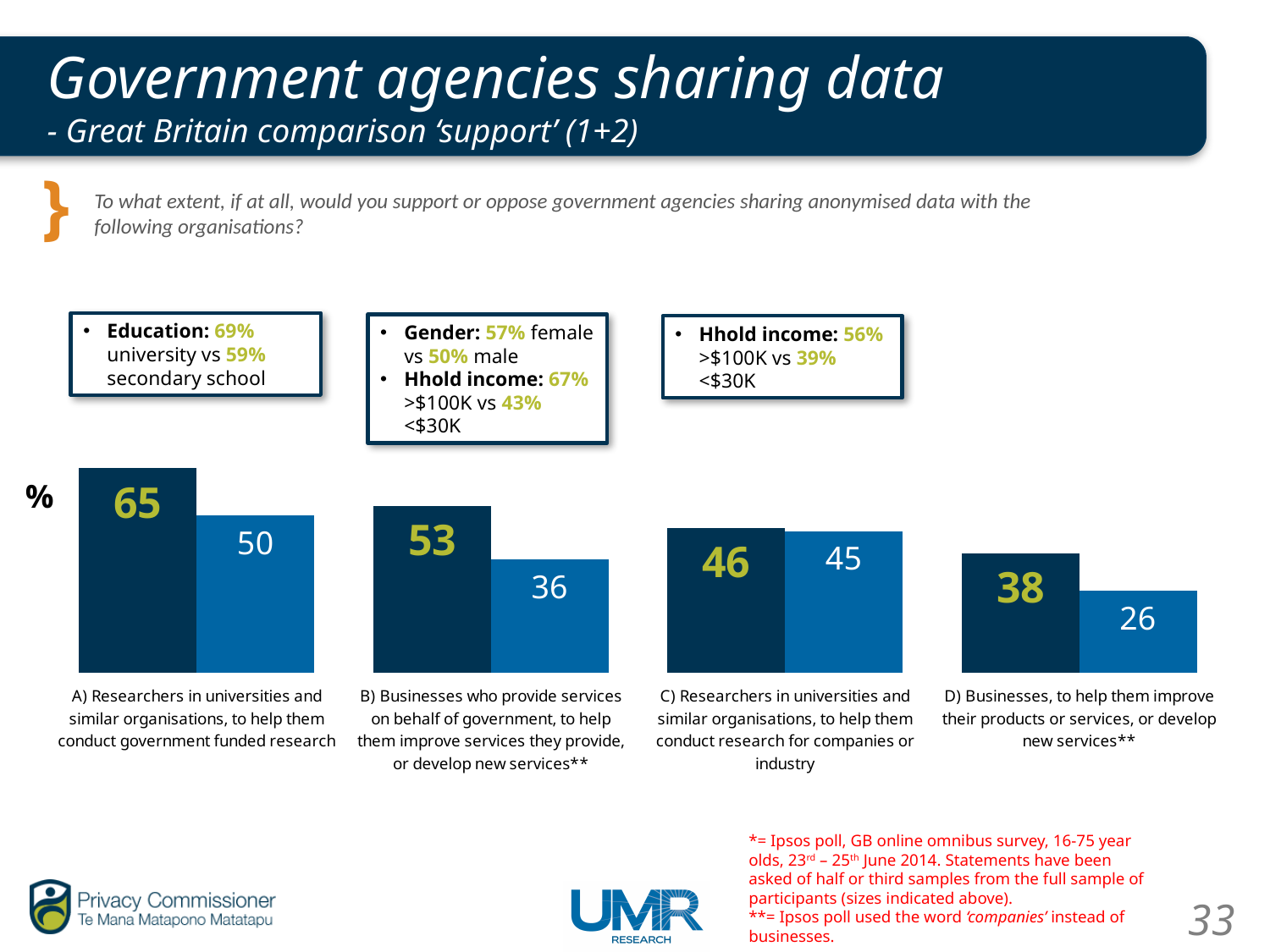
Do the dark navy bar values rise or fall moving from category A to category D? fall Which category has the lowest lighter blue bar value? D) Businesses, to help them improve their products or services, or develop new services What is the value of the dark navy bar for category A) Researchers in universities and similar organisations, to help them conduct government funded research? 65 What is the difference between the dark navy bar and the lighter blue bar for category B? 17 What is the difference between the dark navy bar values for category A and category D? 27 How many categories (A to D) are plotted in the chart? 4 Which is larger: the lighter blue bar for category A or the lighter blue bar for category C? category A (50) What is the value of the lighter blue bar for category C) Researchers in universities and similar organisations, to help them conduct research for companies or industry? 45 What is the value of the lighter blue bar for category B) Businesses who provide services on behalf of government? 36 What is the value of the dark navy bar for category D) Businesses, to help them improve their products or services, or develop new services? 38 Which category has the highest dark navy bar value? A) Researchers in universities and similar organisations, to help them conduct government funded research What kind of chart is shown on the slide? bar chart